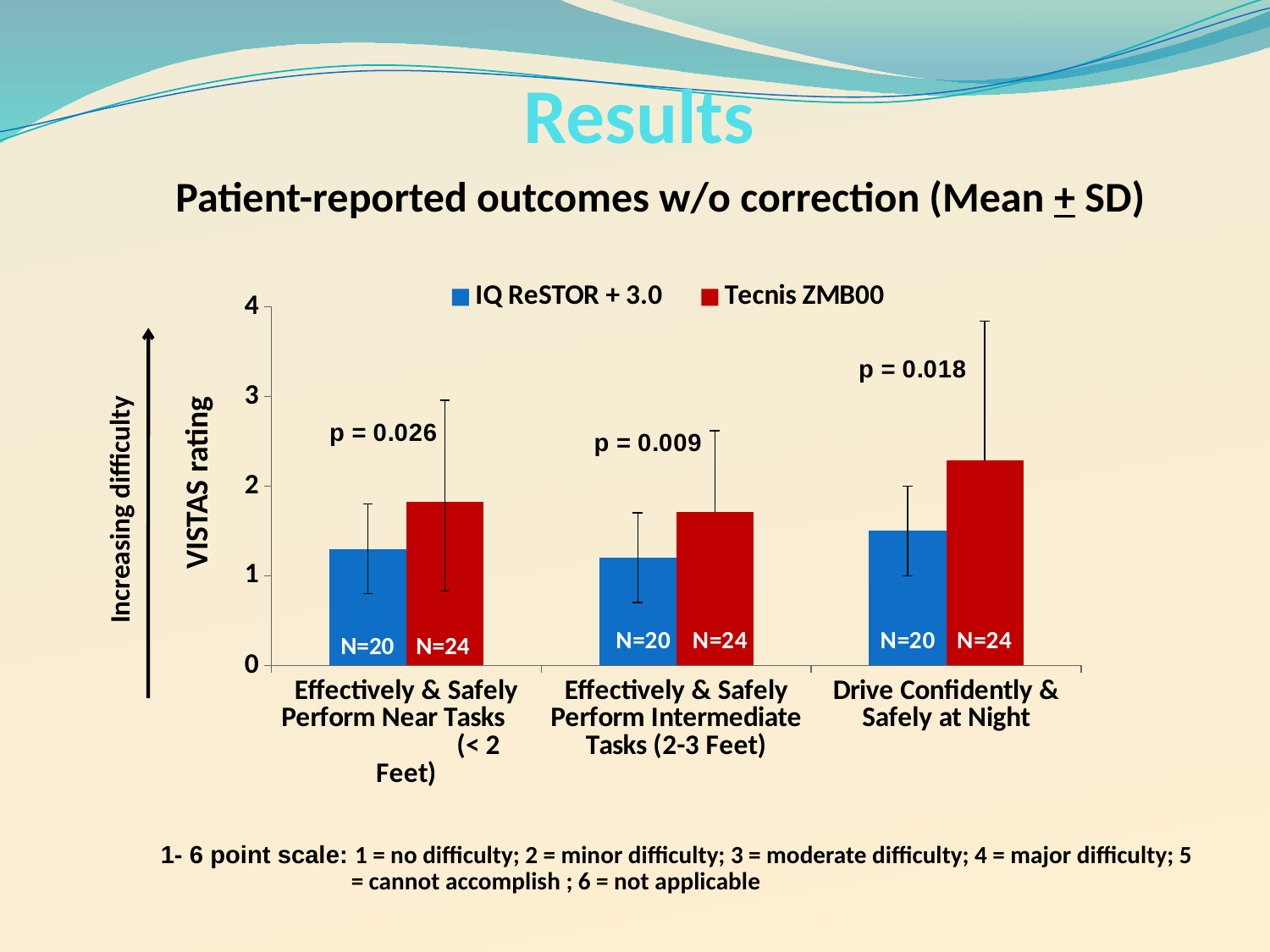
How many task categories are shown on the x axis? 3 Is the Tecnis ZMB00 value for 'Drive Confidently & Safely at Night' greater or less than 2? greater What kind of chart is shown on the slide? bar chart Is the IQ ReSTOR + 3.0 value for 'Effectively & Safely Perform Near Tasks (< 2 Feet)' greater or less than 2? less Which bar in the chart is the highest overall? Tecnis ZMB00 for Drive Confidently & Safely at Night For 'Effectively & Safely Perform Near Tasks (< 2 Feet)', which lens has the lower VISTAS rating? IQ ReSTOR + 3.0 For 'Drive Confidently & Safely at Night', which lens has the higher VISTAS rating, IQ ReSTOR + 3.0 or Tecnis ZMB00? Tecnis ZMB00 Is the Tecnis ZMB00 value for 'Effectively & Safely Perform Intermediate Tasks (2-3 Feet)' greater or less than 1? greater How many series does the legend list? 2 What p-value is shown for 'Effectively & Safely Perform Intermediate Tasks (2-3 Feet)'? p = 0.009 What is the y-axis label of the chart? VISTAS rating Which series is shown in red? Tecnis ZMB00